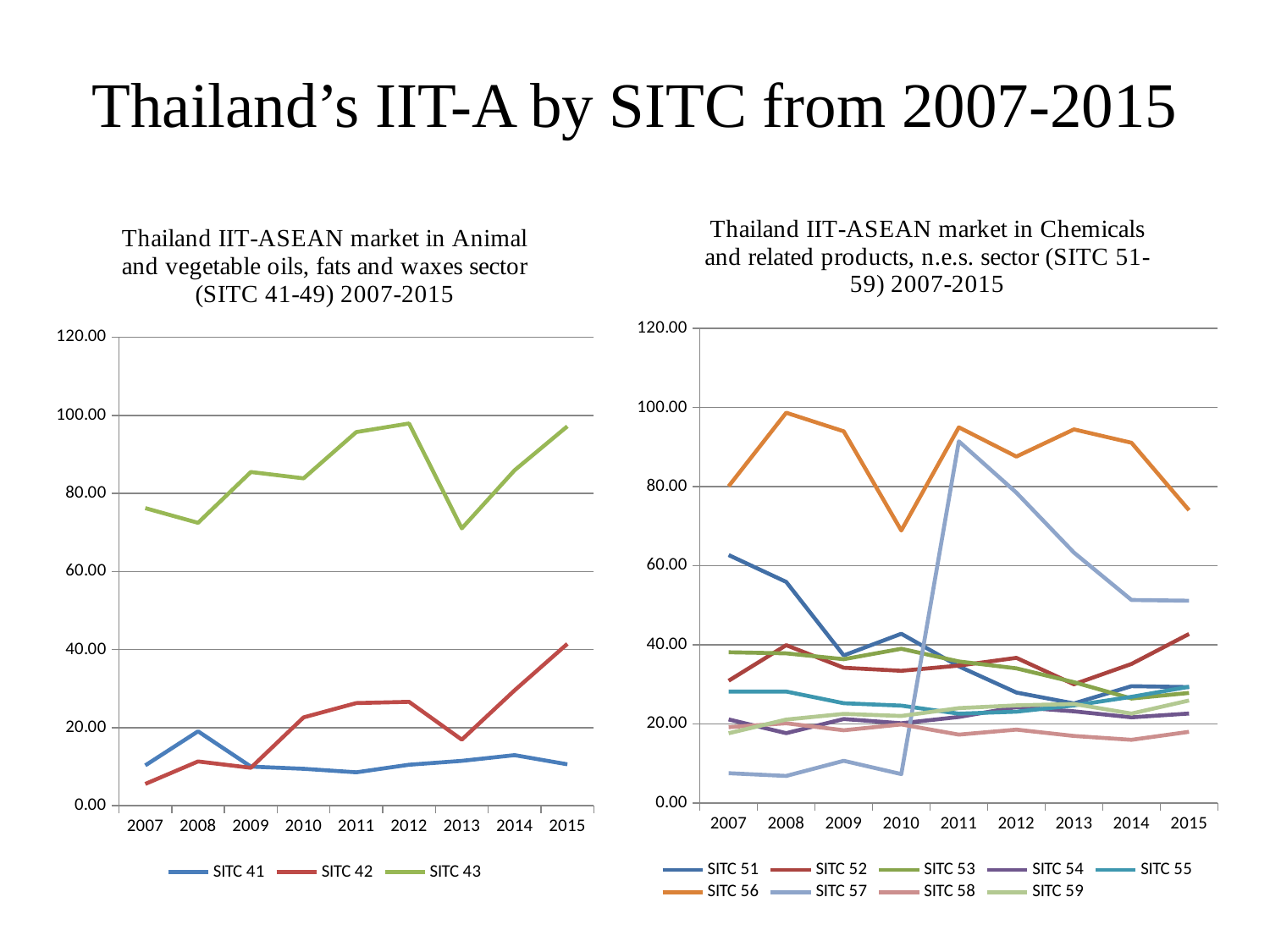
On the left chart (SITC 41-49), which is larger in 2015, SITC 41 or SITC 42? SITC 42 On the right chart (SITC 51-59), does the value for SITC 57 rise or fall from 2011 to 2015? fall On the left chart (SITC 41-49), how many years are shown on the x axis? 9 On the right chart (SITC 51-59), how many series does the legend list? 9 On the right chart (SITC 51-59), which series has the lowest value in 2007? SITC 57 On the left chart (SITC 41-49), how many series does the legend list? 3 On the right chart (SITC 51-59), which series has the highest value in 2008? SITC 56 On the left chart (SITC 41-49), is the value for SITC 43 in 2012 greater or less than 80.00? greater On the left chart (SITC 41-49), is the value for SITC 42 in 2013 greater or less than 20.00? less What kind of chart is the right chart (SITC 51-59)? line chart On the right chart (SITC 51-59), is the value for SITC 57 in 2011 greater or less than 80.00? greater On the left chart (SITC 41-49), which series has the highest value in 2012? SITC 43